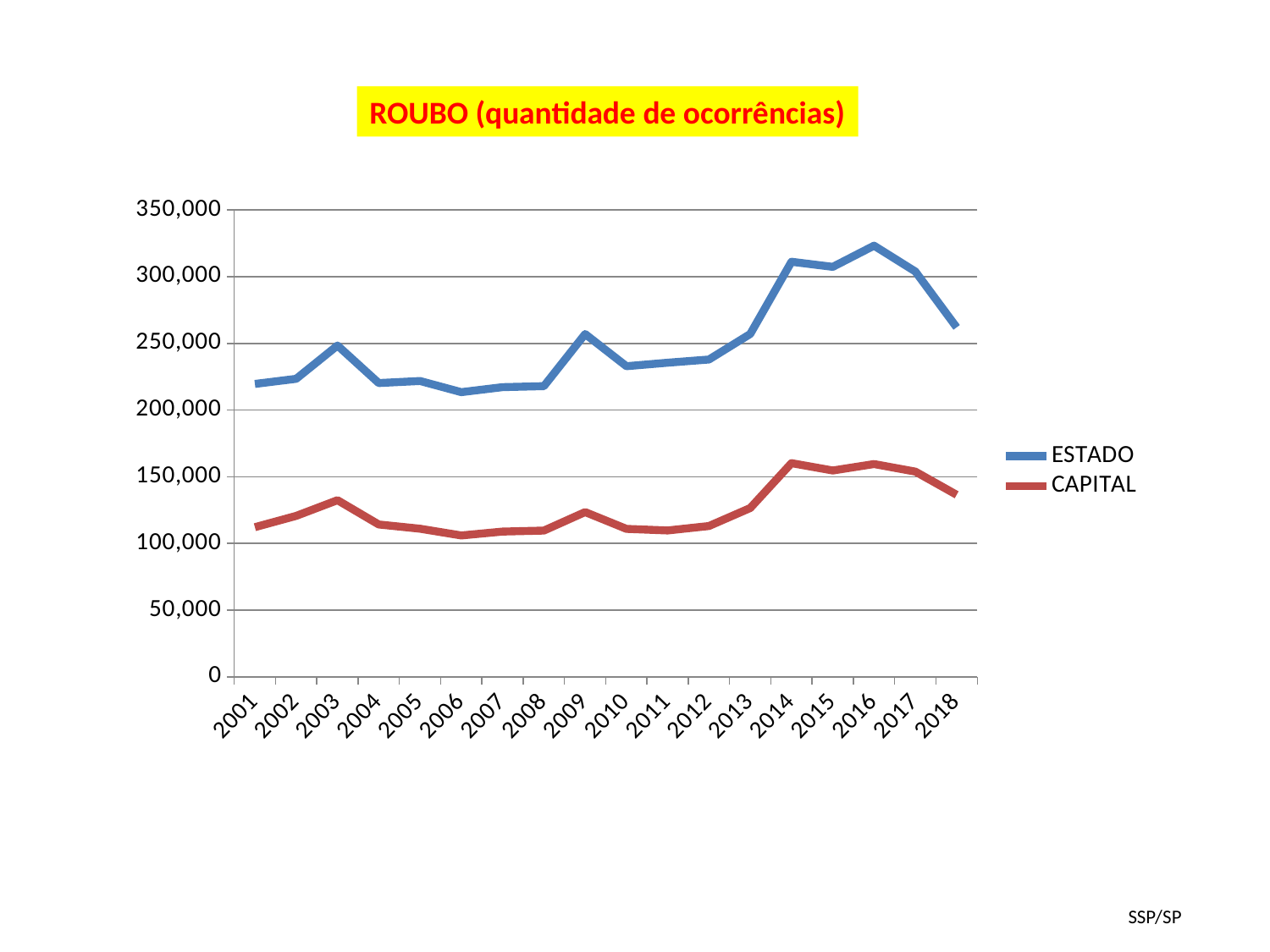
In which year does the ESTADO series reach its highest value? 2016 Is the CAPITAL value for 2006 greater or less than 100,000? greater Is the ESTADO value for 2018 greater or less than 300,000? less Is the CAPITAL value for 2014 greater or less than 150,000? greater Which is larger, the ESTADO value for 2016 or the ESTADO value for 2018? 2016 How many years are shown on the x axis? 18 Which series has the higher value in 2010, ESTADO or CAPITAL? ESTADO Does the ESTADO series rise or fall from 2016 to 2018? fall How many series does the legend list? 2 What kind of chart is shown on the slide? line chart What is the title of the chart? ROUBO (quantidade de ocorrências)